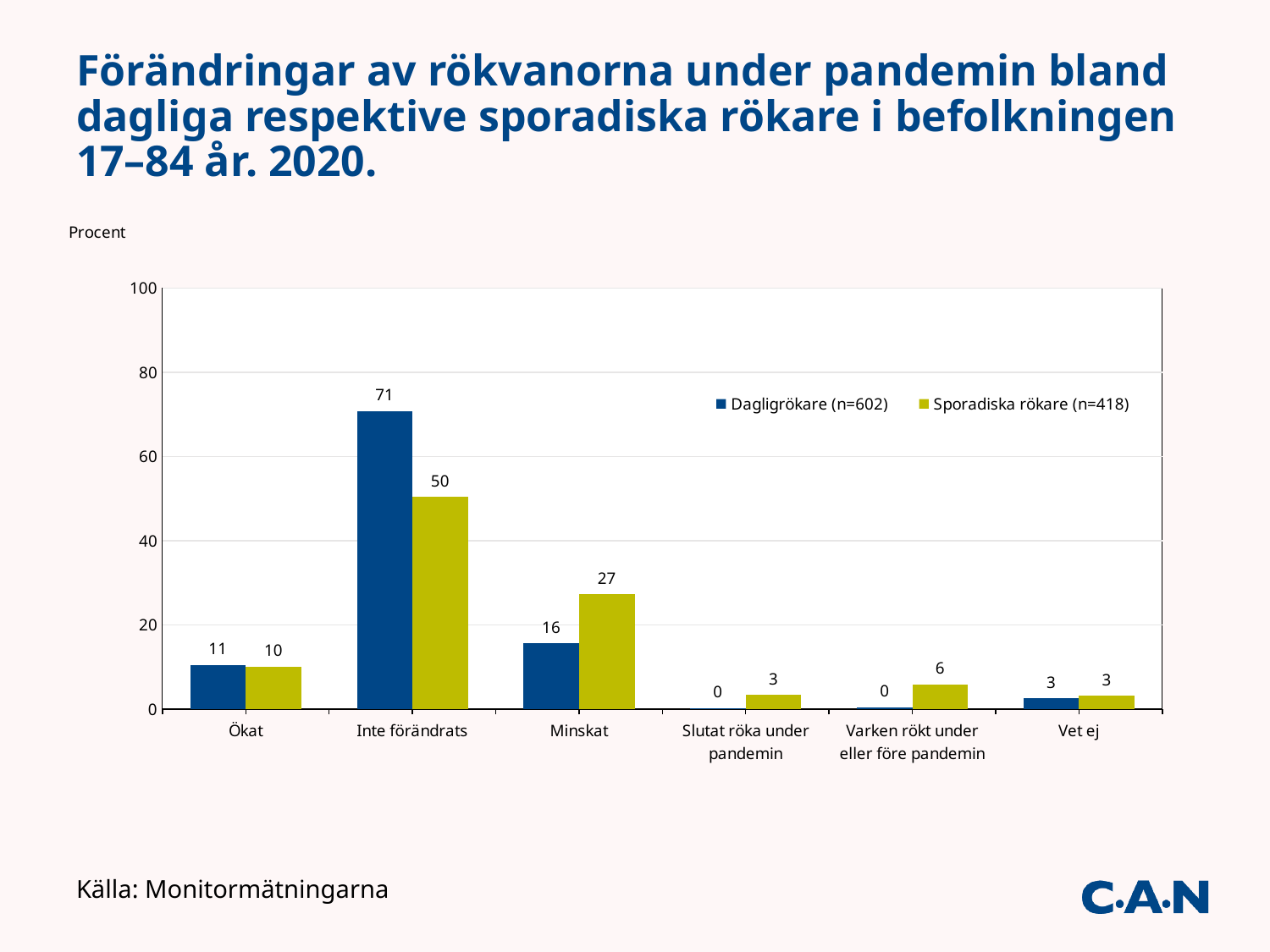
Is the value for Sporadiska rökare (n=418) in the Inte förändrats category greater or less than 40? greater What is the value for Dagligrökare (n=602) in the Inte förändrats category? 71 What is the value for Sporadiska rökare (n=418) in the Minskat category? 27 How many categories are shown on the x axis? 6 What kind of chart is shown on the slide? Bar chart How many series does the legend list? 2 Which category has the highest value for Dagligrökare (n=602)? Inte förändrats Which series has the larger value in the Minskat category? Sporadiska rökare (n=418) What is the difference between the Dagligrökare (n=602) and Sporadiska rökare (n=418) values in the Inte förändrats category? 21 What is the value for Sporadiska rökare (n=418) in the Varken rökt under eller före pandemin category? 6 What is the source given at the bottom of the slide? Monitormätningarna